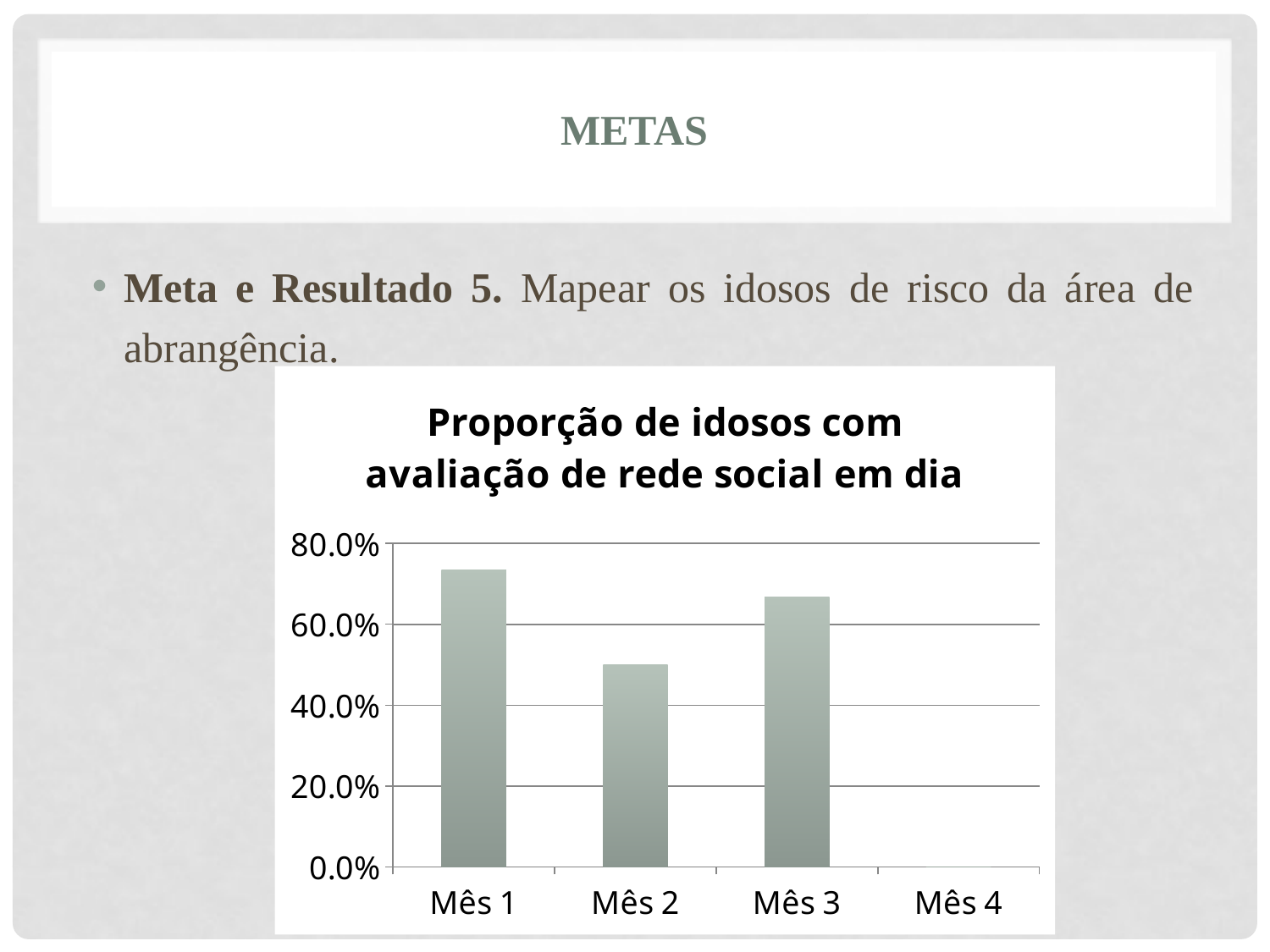
Is the value for Mês 2 greater or less than 60.0%? less Is the value for Mês 1 greater or less than 60.0%? greater How many categories are shown on the x axis of the chart? 4 What is the highest tick value shown on the y axis? 80.0% Does the value rise or fall from Mês 1 to Mês 2? fall Which of the months with a visible bar has the highest value? Mês 1 What kind of chart is shown on the slide? bar chart What is the title of the chart? Proporção de idosos com avaliação de rede social em dia Is the value for Mês 1 greater or less than 80.0%? less Among Mês 1, Mês 2 and Mês 3, which has the lowest value? Mês 2 Which is larger, the value for Mês 1 or the value for Mês 3? Mês 1